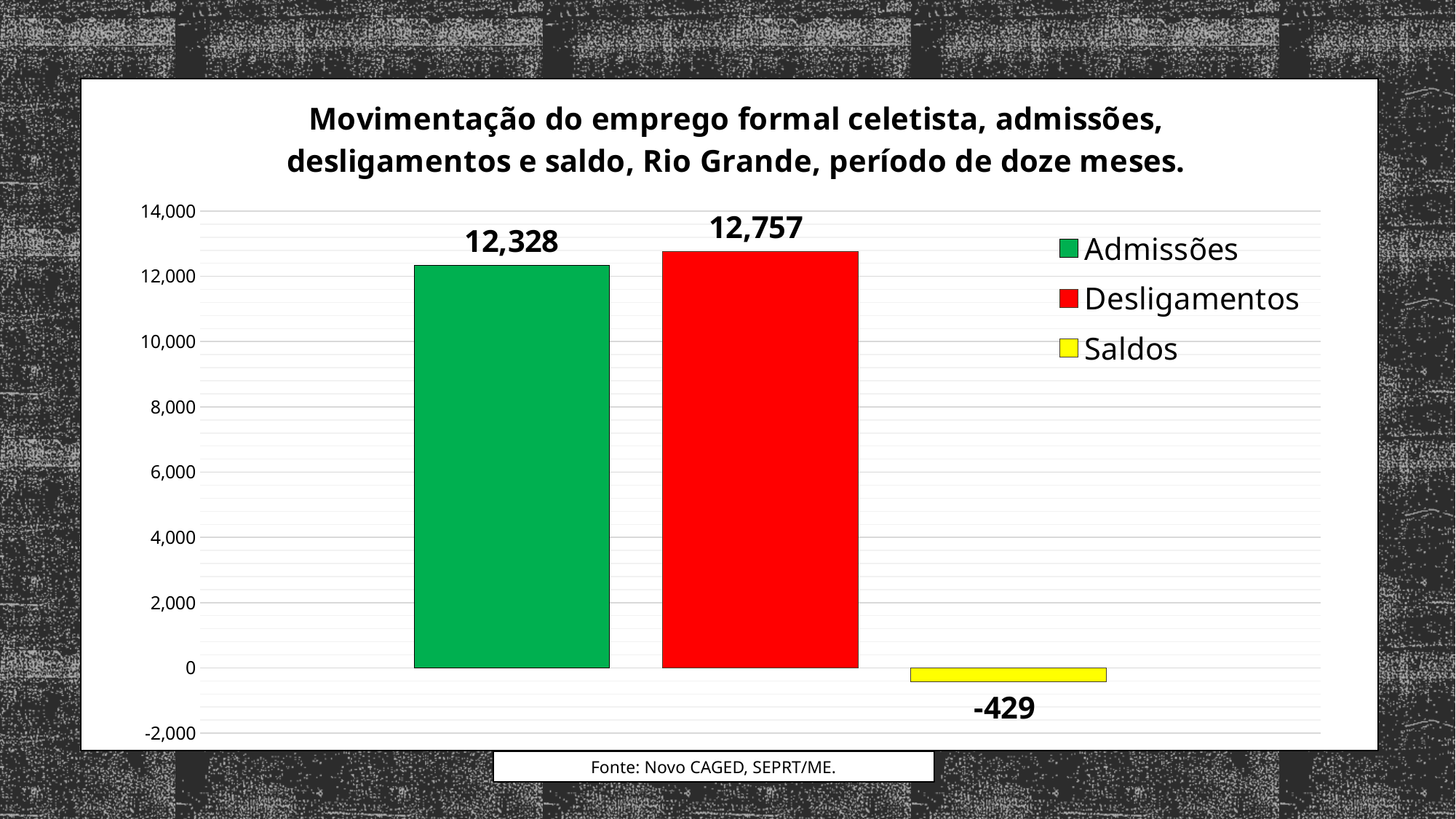
What is the difference between Desligamentos and Admissões? 429 What is the value for Desligamentos? 12,757 What kind of chart is shown? bar chart What is the value for Admissões? 12,328 Which series has the highest value? Desligamentos What is the value for Saldos? -429 How many series does the legend list? 3 What colour is the bar for Saldos? yellow Is the value for Admissões greater or less than 12,000? greater What source is cited below the chart? Novo CAGED, SEPRT/ME. Which series has the lowest value? Saldos Which is larger, Admissões or Desligamentos? Desligamentos